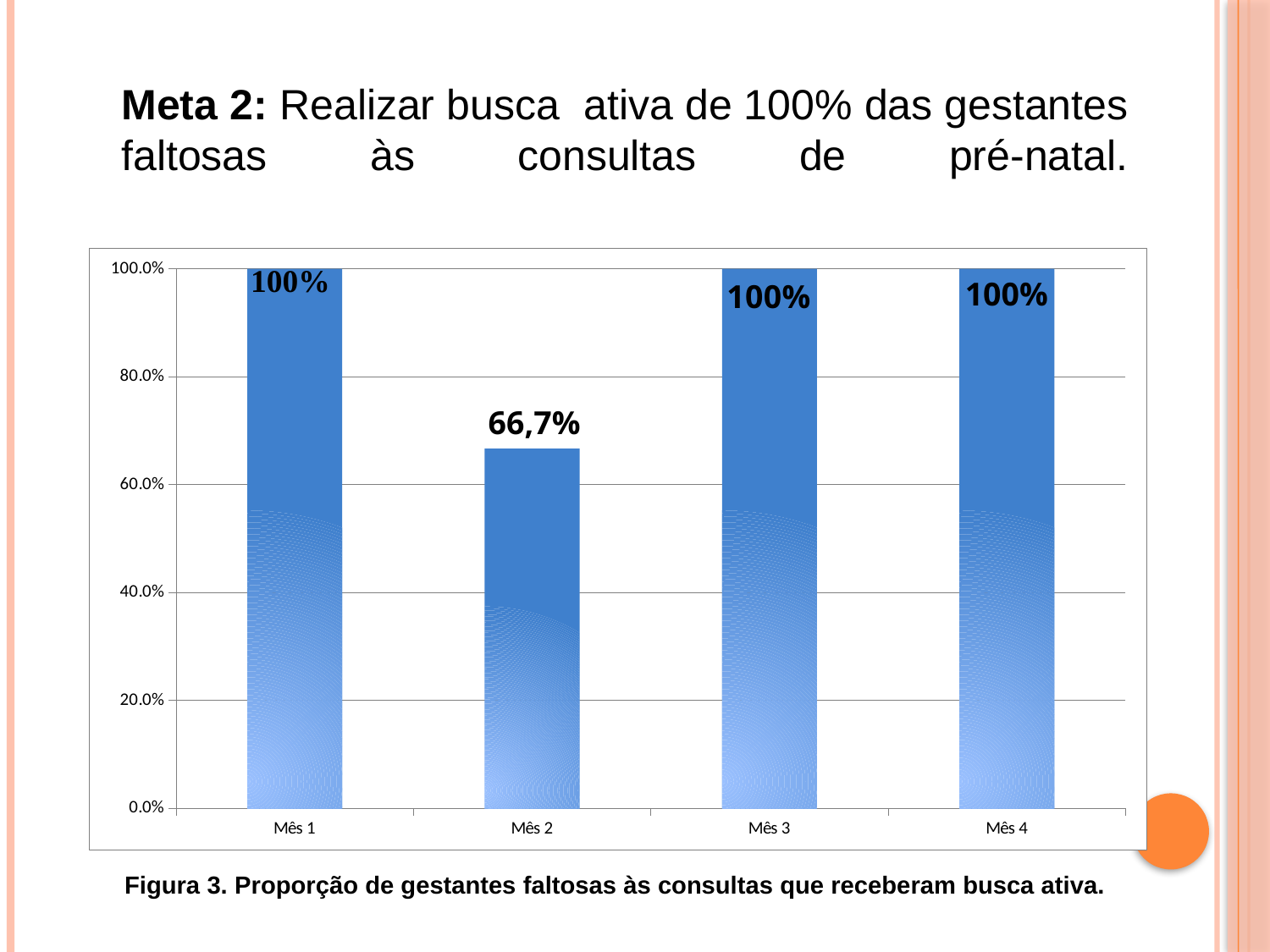
What is the value for Mês 4? 100% Which month has the lowest value? Mês 2 Which is larger, the value for Mês 1 or the value for Mês 2? Mês 1 What kind of chart is shown on the slide? bar chart Is the value for Mês 2 greater or less than 60.0%? greater What is the value for Mês 2? 66,7% What is the highest value shown on the y axis? 100.0% What is the value for Mês 3? 100% How many months are shown on the x axis? 4 What is the value for Mês 1? 100% What is the figure caption below the chart? Figura 3. Proporção de gestantes faltosas às consultas que receberam busca ativa. Is the value for Mês 2 greater or less than 80.0%? less